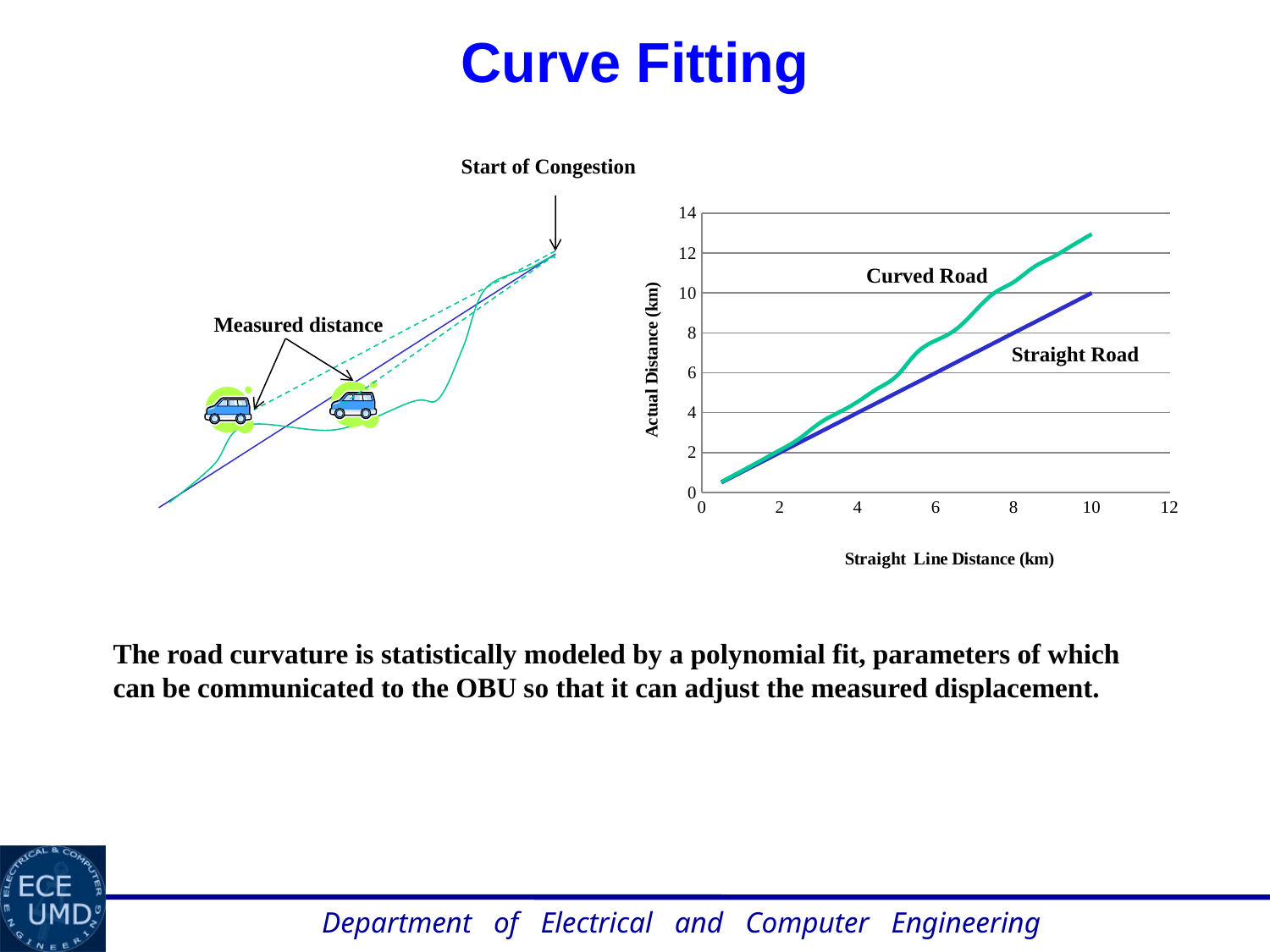
At a straight line distance of 10 km, which series has the larger actual distance, Curved Road or Straight Road? Curved Road What are the names of the two series plotted on the chart? Curved Road and Straight Road Do the values of the Curved Road series rise or fall as the straight line distance increases? rise Is the actual distance for the Curved Road at a straight line distance of 6 km greater or less than 6? greater Is the actual distance for the Curved Road at a straight line distance of 10 km greater or less than 12? greater How many series are plotted on the chart? 2 Is the actual distance for the Straight Road at a straight line distance of 8 km greater or less than 10? less What is the title of the y axis of the chart? Actual Distance (km) What is the actual distance for the Straight Road at a straight line distance of 10 km? 10 What kind of chart is shown on the slide? line chart What is the maximum value shown on the y axis of the chart? 14